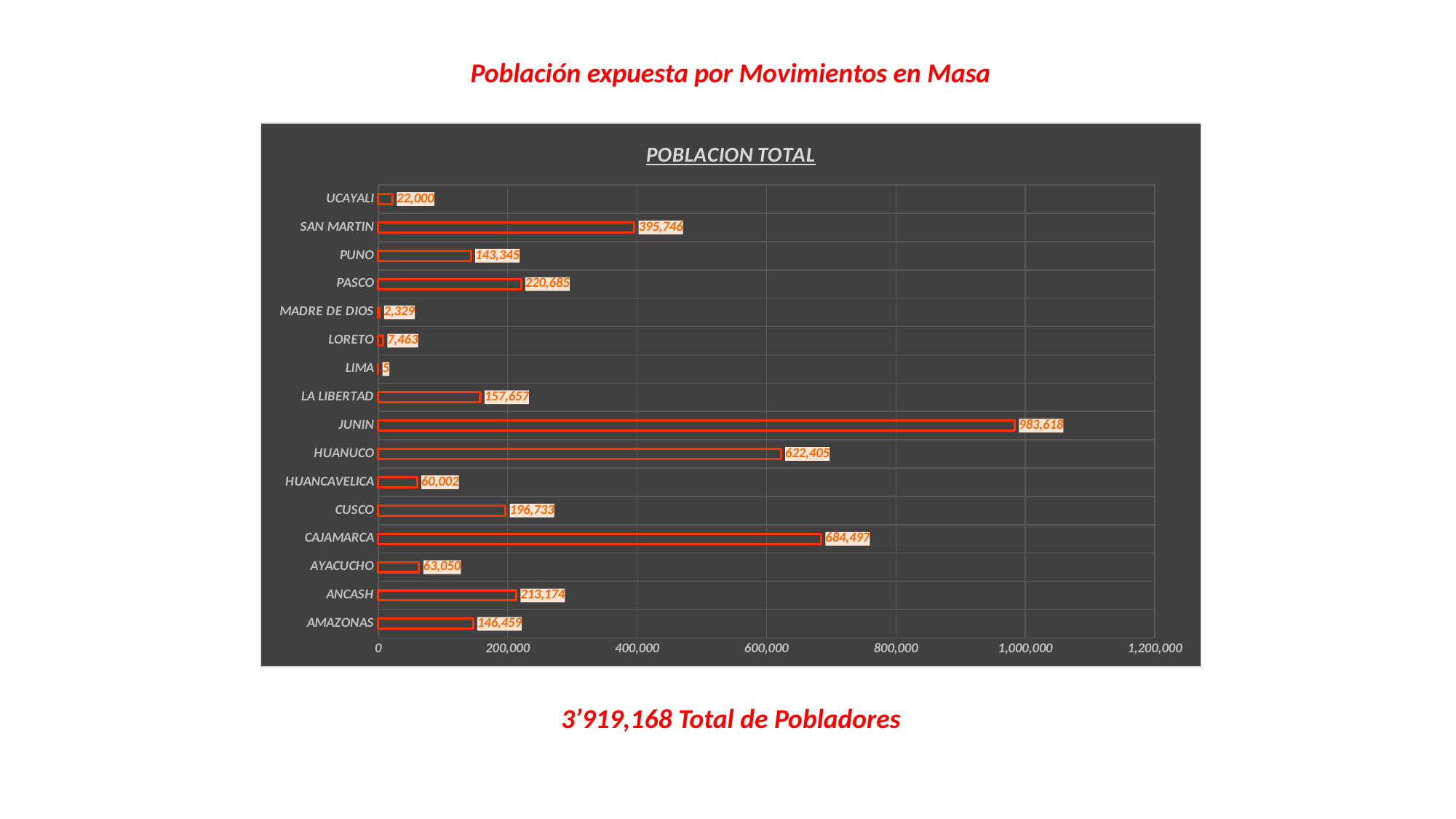
Is the value for CAJAMARCA greater or less than 600,000? greater Which region has the lowest value in the chart? LIMA What kind of chart is shown on the slide? bar chart What is the value for JUNIN in the POBLACION TOTAL chart? 983,618 Which region has the highest value in the chart? JUNIN How many regions are shown in the chart? 16 What is the value for MADRE DE DIOS? 2,329 What is the value for CAJAMARCA? 684,497 What is the value for LIMA? 5 Which is larger, the value for SAN MARTIN or the value for PASCO? SAN MARTIN What is the difference between the values for CAJAMARCA and HUANUCO? 62,092 What is the difference between the values for JUNIN and CAJAMARCA? 299,121